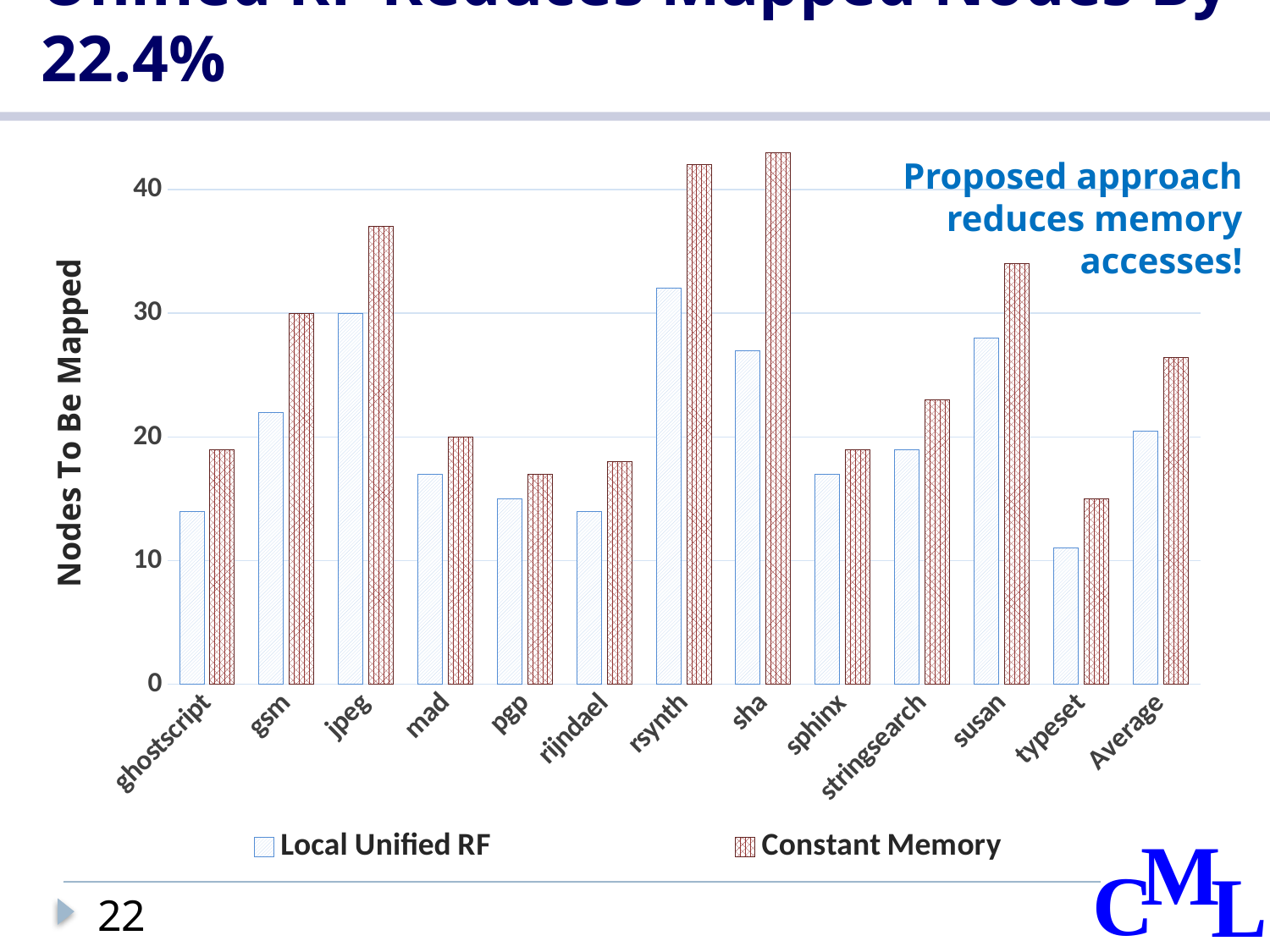
Which category has the highest Local Unified RF value? rsynth For ghostscript, which is larger: Local Unified RF or Constant Memory? Constant Memory Is the Constant Memory value for Average greater or less than 20? greater What is the label of the y axis? Nodes To Be Mapped Is the Constant Memory value for jpeg greater or less than 30? greater Which category has the lowest Local Unified RF value? typeset What are the two series named in the legend? Local Unified RF and Constant Memory Is the Local Unified RF value for typeset greater or less than 20? less How many series does the legend list? 2 What kind of chart is shown on the slide? bar chart How many categories are shown along the x axis? 13